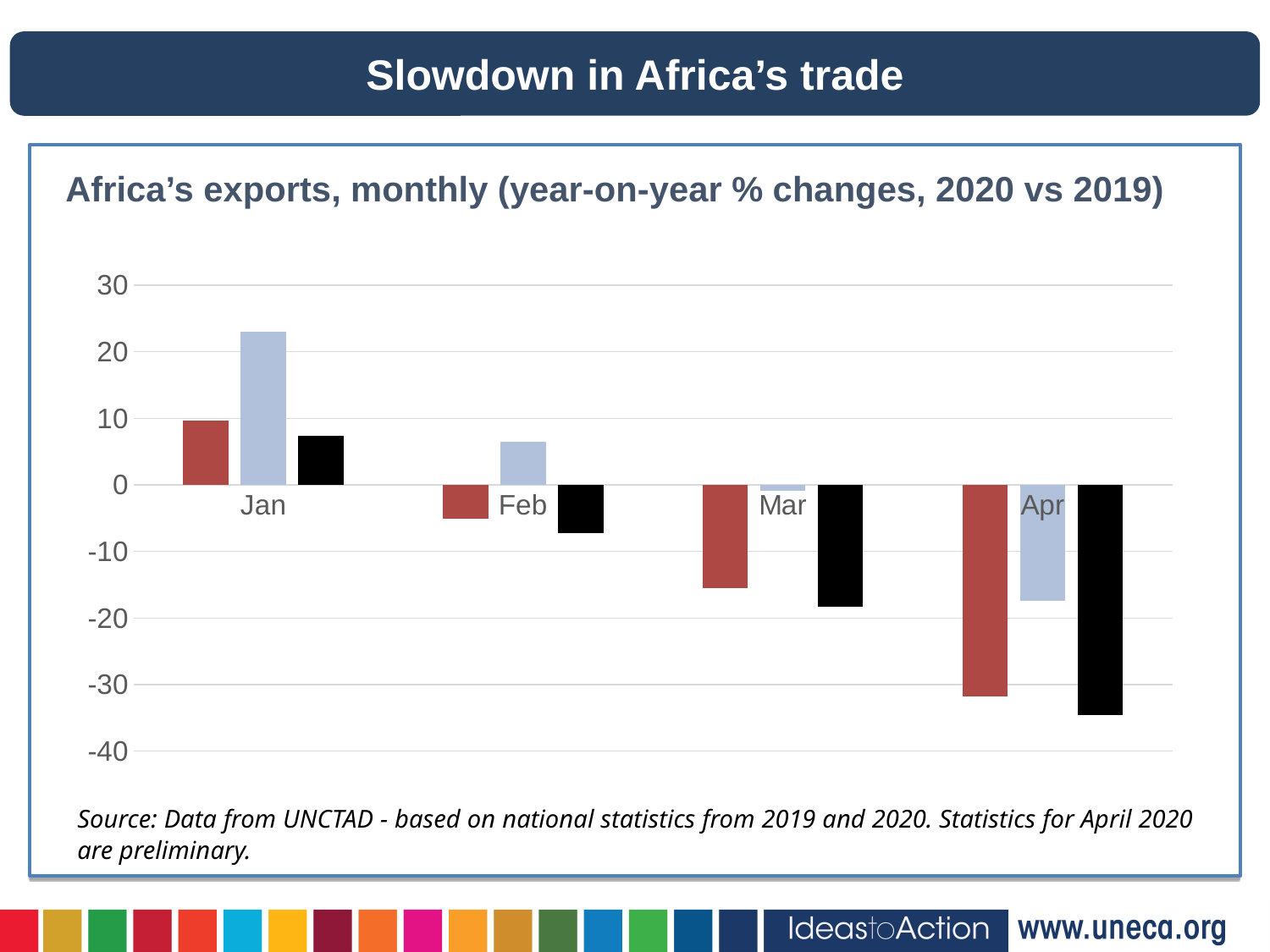
Is the value of the black bar for Mar greater or less than -10? less In which month is the black bar lowest? Apr Is the value of the light blue bar for Jan greater or less than 20? greater What is the title of the chart? Africa's exports, monthly (year-on-year % changes, 2020 vs 2019) How many months are shown on the x axis of the chart? 4 Is the value of the red bar for Apr greater or less than -30? less Do the values in the chart generally rise or fall from Jan to Apr? fall What kind of chart is shown on the slide? bar chart For Jan, which is larger: the red bar or the light blue bar? the light blue bar How many bars are plotted for each month in the chart? 3 In which month is the light blue bar highest? Jan